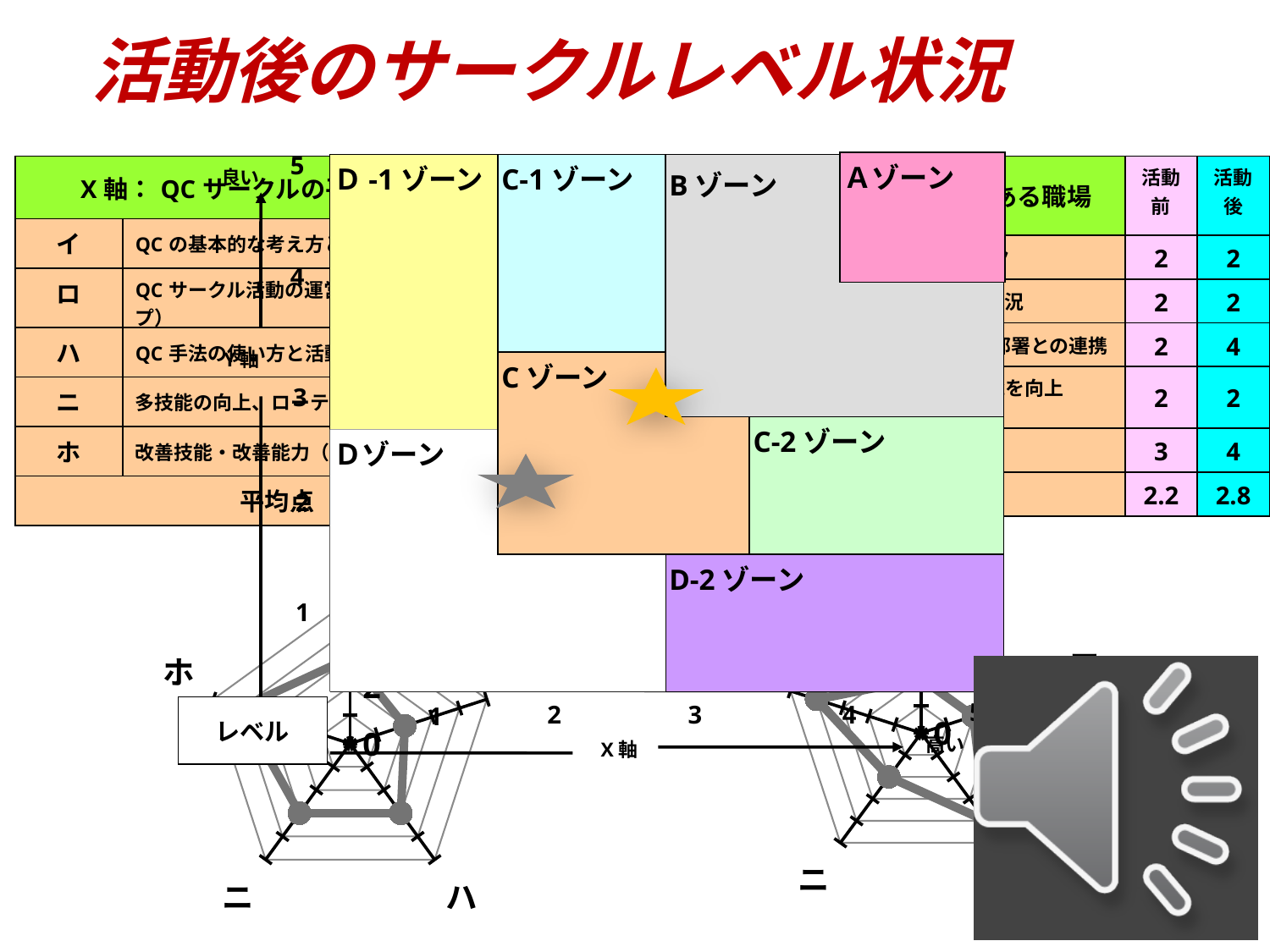
In the table on the slide, what is the 活動後 value for row ハ? 4 How many labelled zones are shown in the zone map in the centre of the slide? 8 In the table on the slide, what is the 平均点 value for 活動前? 2.2 In the table on the slide, which is larger for row ホ, the 活動前 value or the 活動後 value? 活動後 In the table on the slide, what is the 平均点 value for 活動後? 2.8 What kind of chart is shown at the bottom left of the slide? radar chart In the zone map in the centre of the slide, which zone is coloured pink? A ゾーン In the zone map in the centre of the slide, which zone contains the gold star? C ゾーン In the table on the slide, what is the difference between the 活動後 and 活動前 values for row ハ? 2